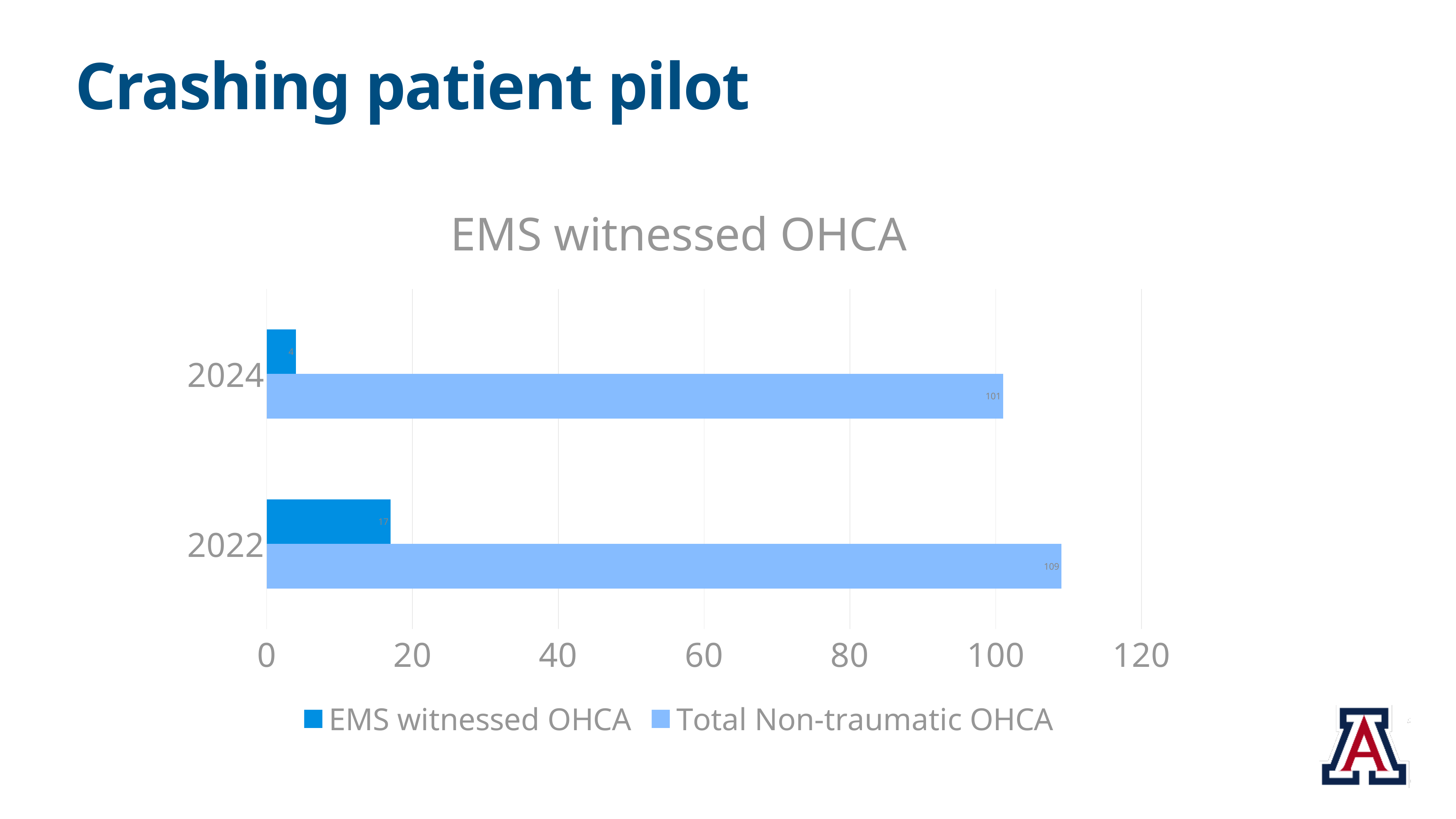
What is the value for Total Non-traumatic OHCA in 2022? 109 Which year has the higher value for EMS witnessed OHCA? 2022 What is the difference between the EMS witnessed OHCA values for 2022 and 2024? 13 How many years are shown on the chart? 2 What is the value for EMS witnessed OHCA in 2022? 17 What kind of chart is shown on the slide? Bar chart How many series does the legend list? 2 Which year has the lower value for Total Non-traumatic OHCA? 2024 What is the value for EMS witnessed OHCA in 2024? 4 Is the Total Non-traumatic OHCA value for 2024 greater or less than 100? greater What is the value for Total Non-traumatic OHCA in 2024? 101 What is the difference between the Total Non-traumatic OHCA values for 2022 and 2024? 8